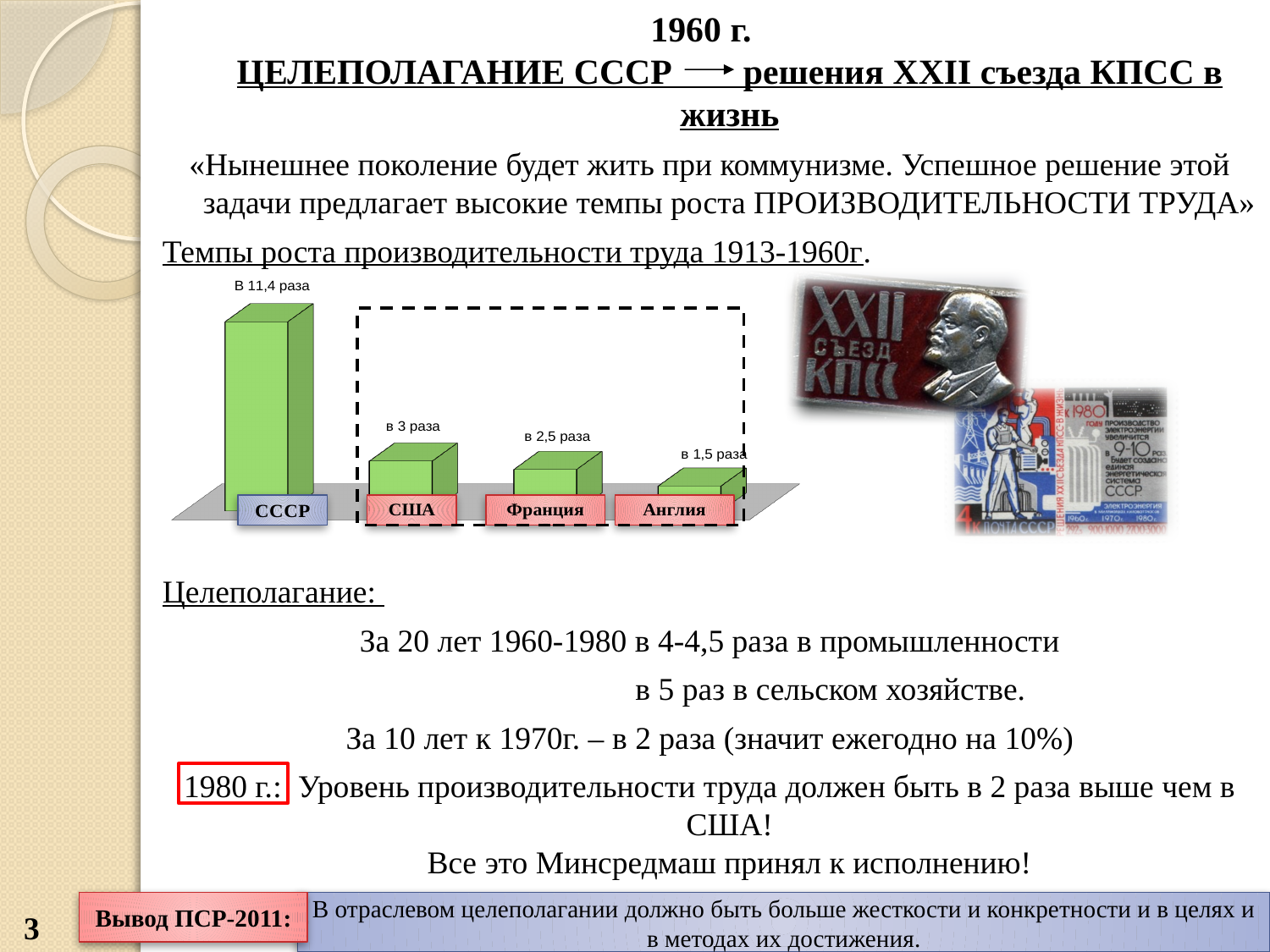
What is the labelled value for Франция in the chart? в 2,5 раза What is the labelled value for США in the chart? в 3 раза What is the labelled value for СССР in the chart 'Темпы роста производительности труда 1913-1960г.'? В 11,4 раза What is the labelled value for Англия in the chart? в 1,5 раза Which has the larger value in the chart, США or Франция? США Which country has the highest bar in the chart? СССР What is the difference between the values for Франция and Англия in the chart? 1 How many countries are shown in the chart? 4 By how much does the value for СССР exceed the value for США in the chart? 8,4 Which three countries are enclosed by the dashed rectangle in the chart? США, Франция, Англия Which country has the lowest bar in the chart? Англия What type of chart is used to show the growth of labour productivity 1913-1960? Bar chart